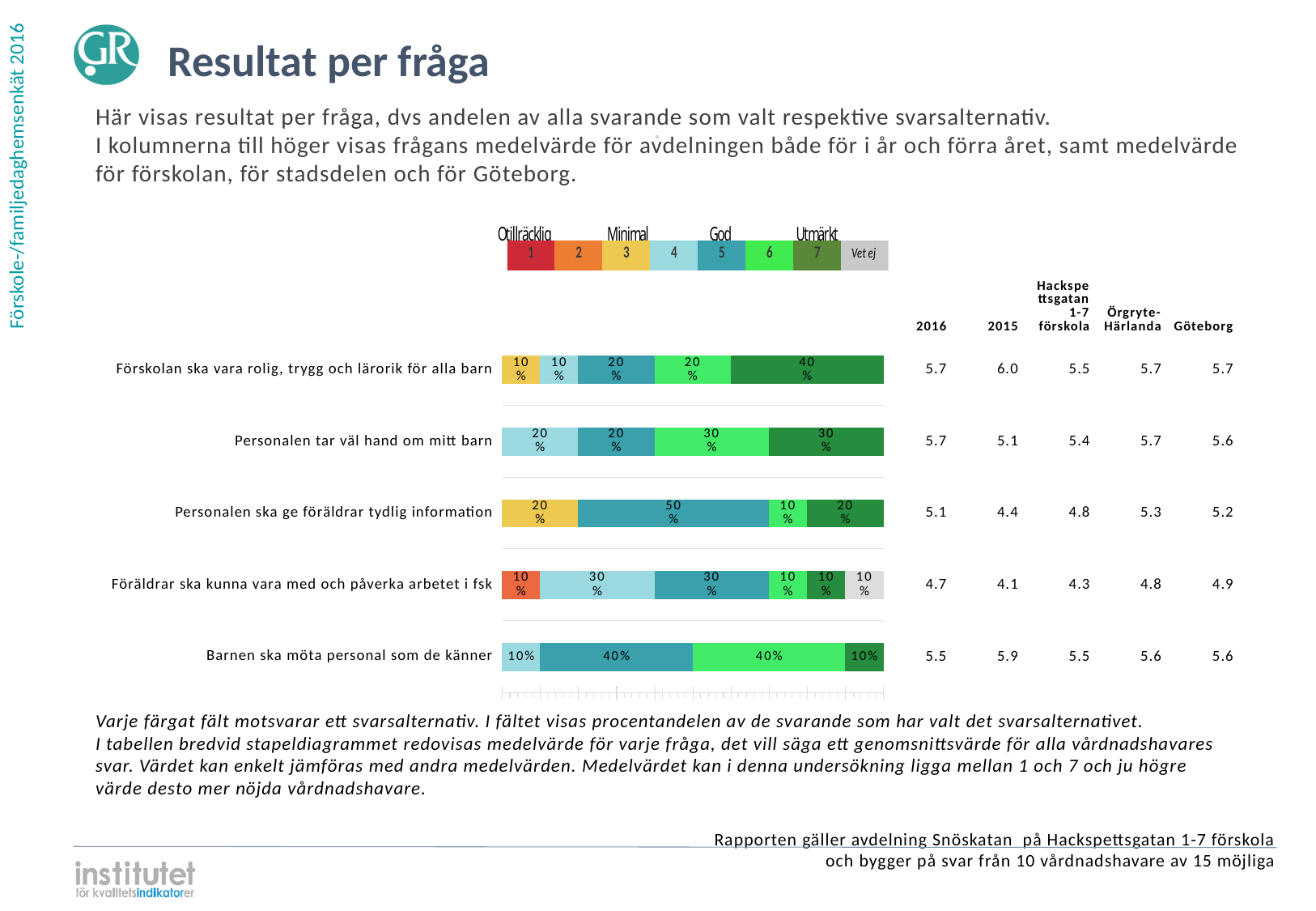
How many questions (categories) are plotted in the bar chart? 5 What percentage of respondents answered "Vet ej" for "Föräldrar ska kunna vara med och påverka arbetet i fsk"? 10% What is the combined share of options 5 and 6 for "Barnen ska möta personal som de känner"? 80% How many response options does the legend above the chart list? 8 What is the difference between the share for option 6 and the share for option 4 in "Personalen tar väl hand om mitt barn"? 10% What kind of chart is shown on the slide? Stacked bar chart Which question has the lowest 2016 mean value in the table next to the chart? Föräldrar ska kunna vara med och påverka arbetet i fsk What label does the legend give to response options 1 and 2? Otillräcklig What percentage of respondents chose option 5 for "Personalen ska ge föräldrar tydlig information"? 50% What percentage of respondents chose option 7 for "Förskolan ska vara rolig, trygg och lärorik för alla barn"? 40% Which response option has the largest share for "Förskolan ska vara rolig, trygg och lärorik för alla barn"? 7 For "Barnen ska möta personal som de känner", is the share for option 5 larger or smaller than the share for option 7? Larger